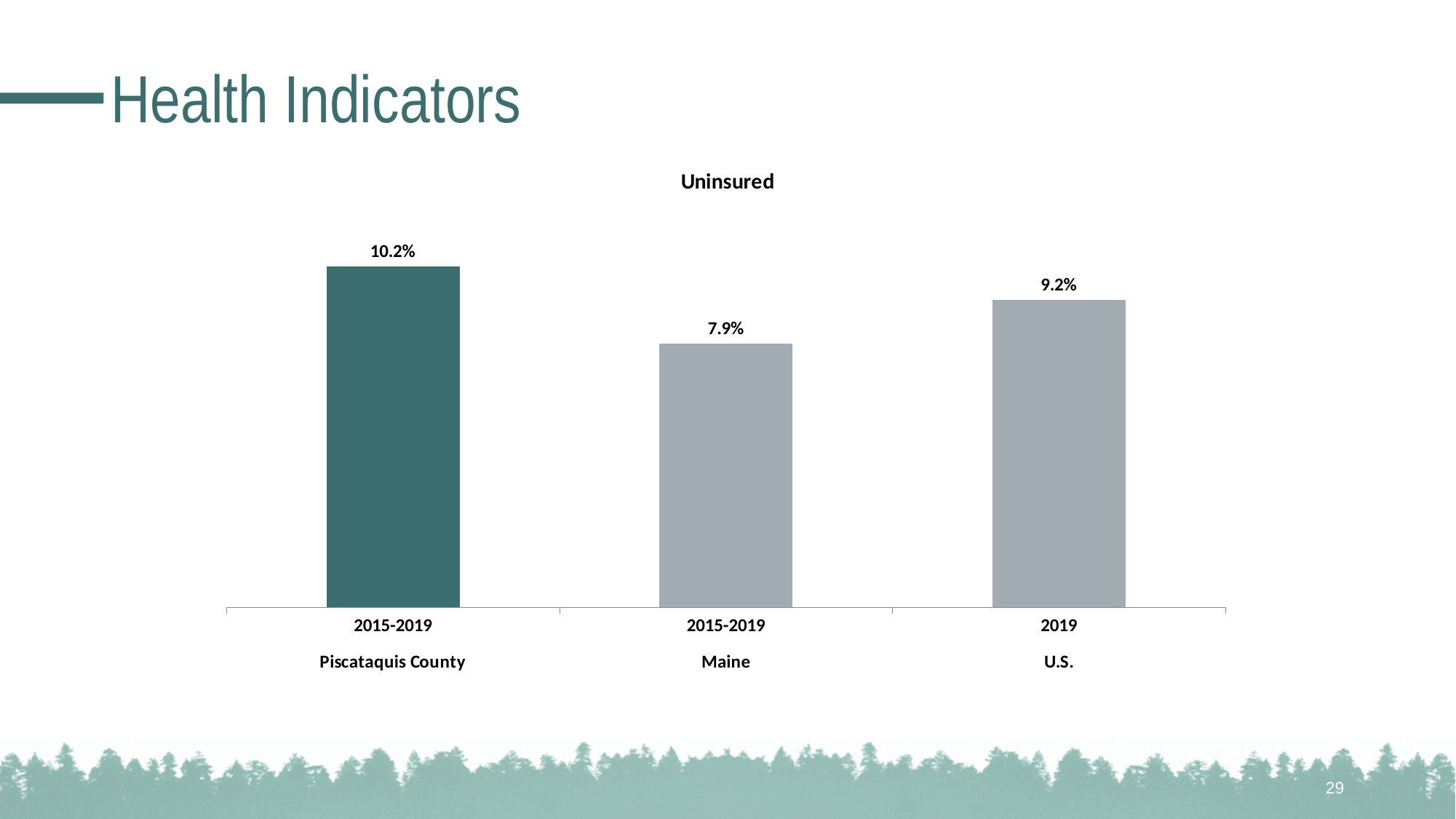
What is the title of the chart? Uninsured Which category has the lowest uninsured rate? Maine Which category has the highest uninsured rate? Piscataquis County Which time period is shown for the U.S. bar? 2019 What is the difference between the uninsured rates of Piscataquis County and Maine? 2.3% What is the uninsured rate for the U.S.? 9.2% What is the uninsured rate for Maine? 7.9% How many categories are shown in the chart? 3 Which has a higher uninsured rate, Maine or the U.S.? U.S. What is the uninsured rate for Piscataquis County? 10.2% What is the difference between the uninsured rates of the U.S. and Maine? 1.3% What kind of chart is shown on the slide? Bar chart